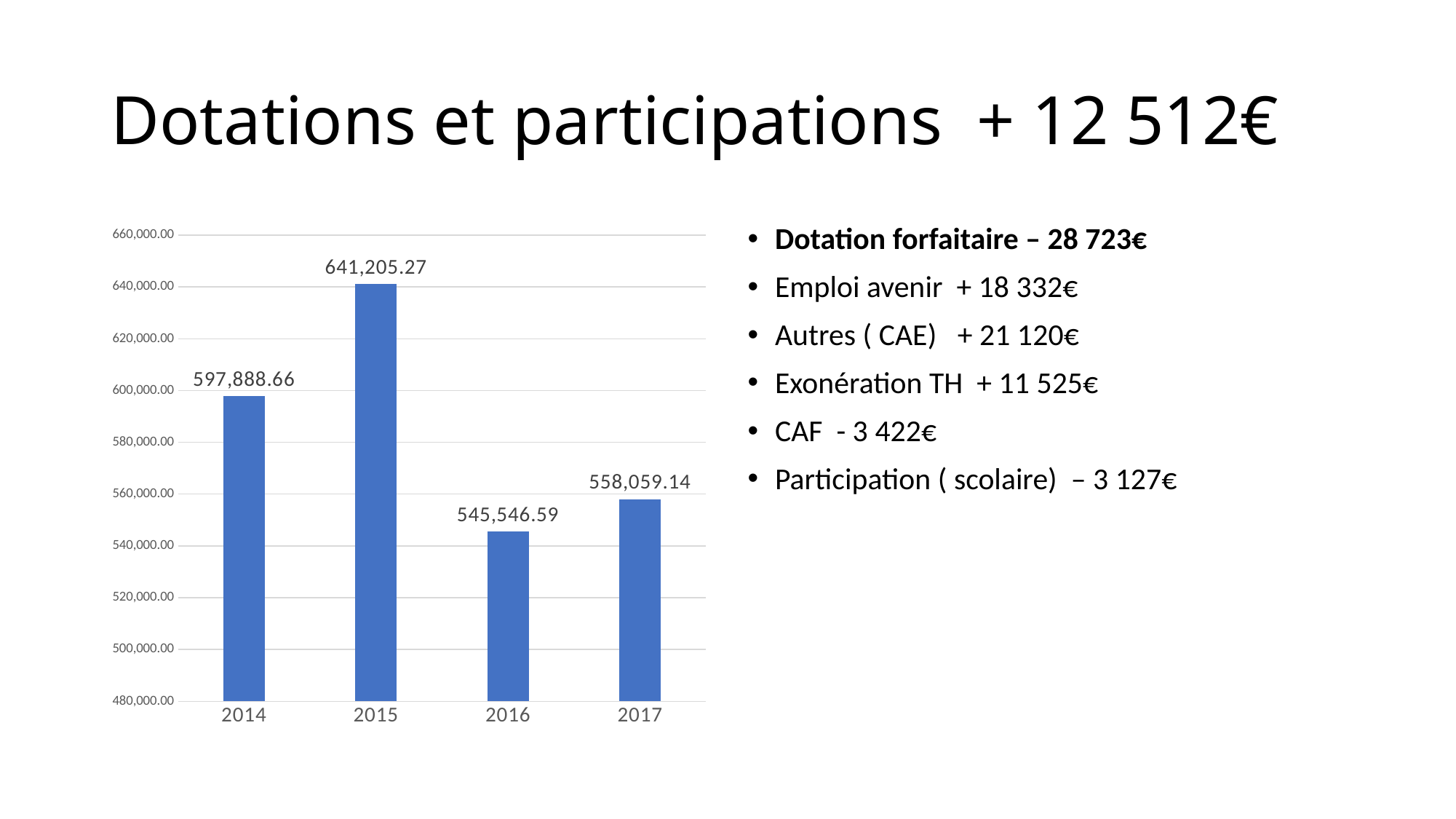
Which is larger, the value for 2014 or the value for 2017? 2014 Is the value for 2016 greater or less than 560,000.00? less How many years are shown on the x axis? 4 What is the difference between the values for 2015 and 2014? 43,316.61 Which year has the lowest value? 2016 What is the difference between the values for 2017 and 2016? 12,512.55 Which year has the highest value? 2015 What is the value for 2017? 558,059.14 What is the value for 2016? 545,546.59 What kind of chart is shown on the slide? bar chart What is the value for 2015? 641,205.27 What is the value for 2014? 597,888.66